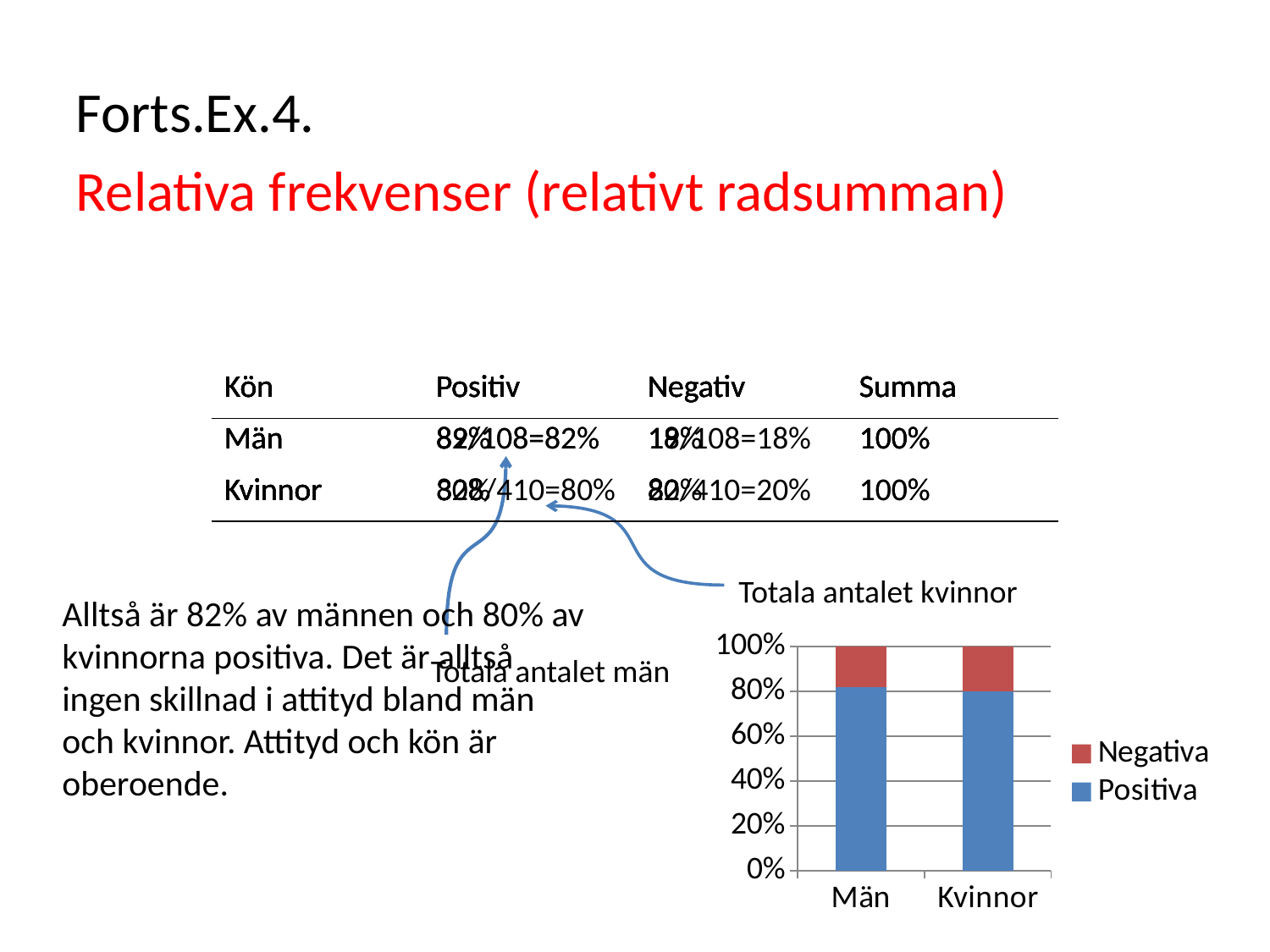
What are the two series listed in the chart legend? Negativa and Positiva Which colour represents the Positiva series in the chart? Blue What is the total height of the stacked bar for Kvinnor? 100% How many categories are shown on the x axis of the chart? 2 How many series does the chart legend list? 2 What is the total height of the stacked bar for Män? 100% Is the Positiva value for Män greater or less than 60%? greater Is the Positiva value for Kvinnor greater or less than 100%? less Is the Negativa share for Kvinnor greater or less than 40%? less What kind of chart is shown on the slide? Stacked bar chart According to the slide, what share of Kvinnor are Positiva? 80% According to the slide, what share of Män are Positiva? 82%